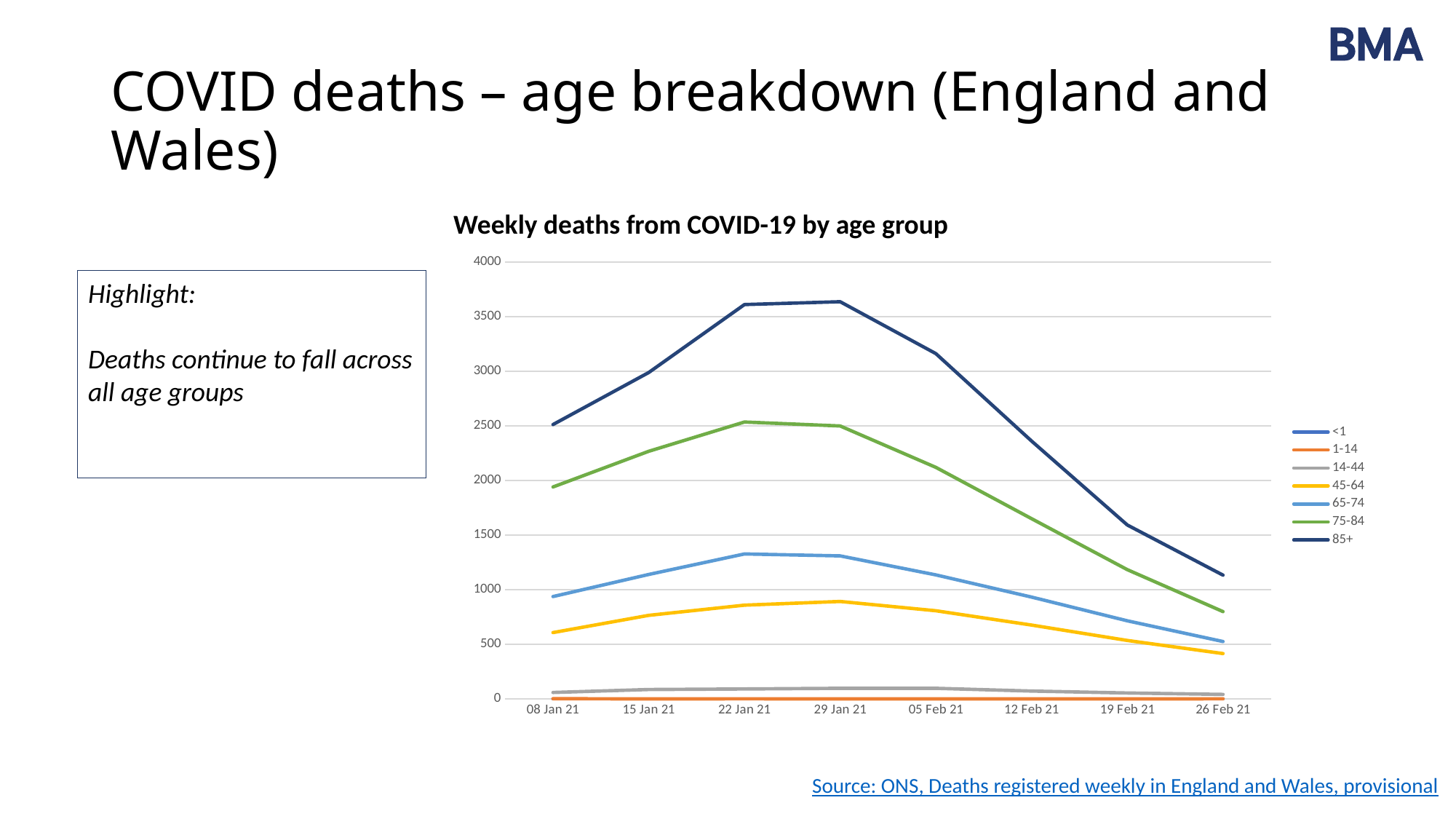
Is the value for the 85+ age group on 22 Jan 21 greater or less than 3500? greater Is the value for the 45-64 age group on 26 Feb 21 greater or less than 500? less Which age group reaches the highest peak on the chart? 85+ How many age-group series does the legend list? 7 Is the value for the 75-84 age group on 08 Jan 21 greater or less than 2000? less Which is larger on 22 Jan 21: the value for 75-84 or the value for 65-74? 75-84 What kind of chart is shown on the slide? Line chart Do weekly deaths for the 85+ age group rise or fall between 29 Jan 21 and 26 Feb 21? Fall Which age group has the highest weekly deaths throughout the period shown? 85+ How many weekly dates are shown on the x axis? 8 What is the title of the chart? Weekly deaths from COVID-19 by age group